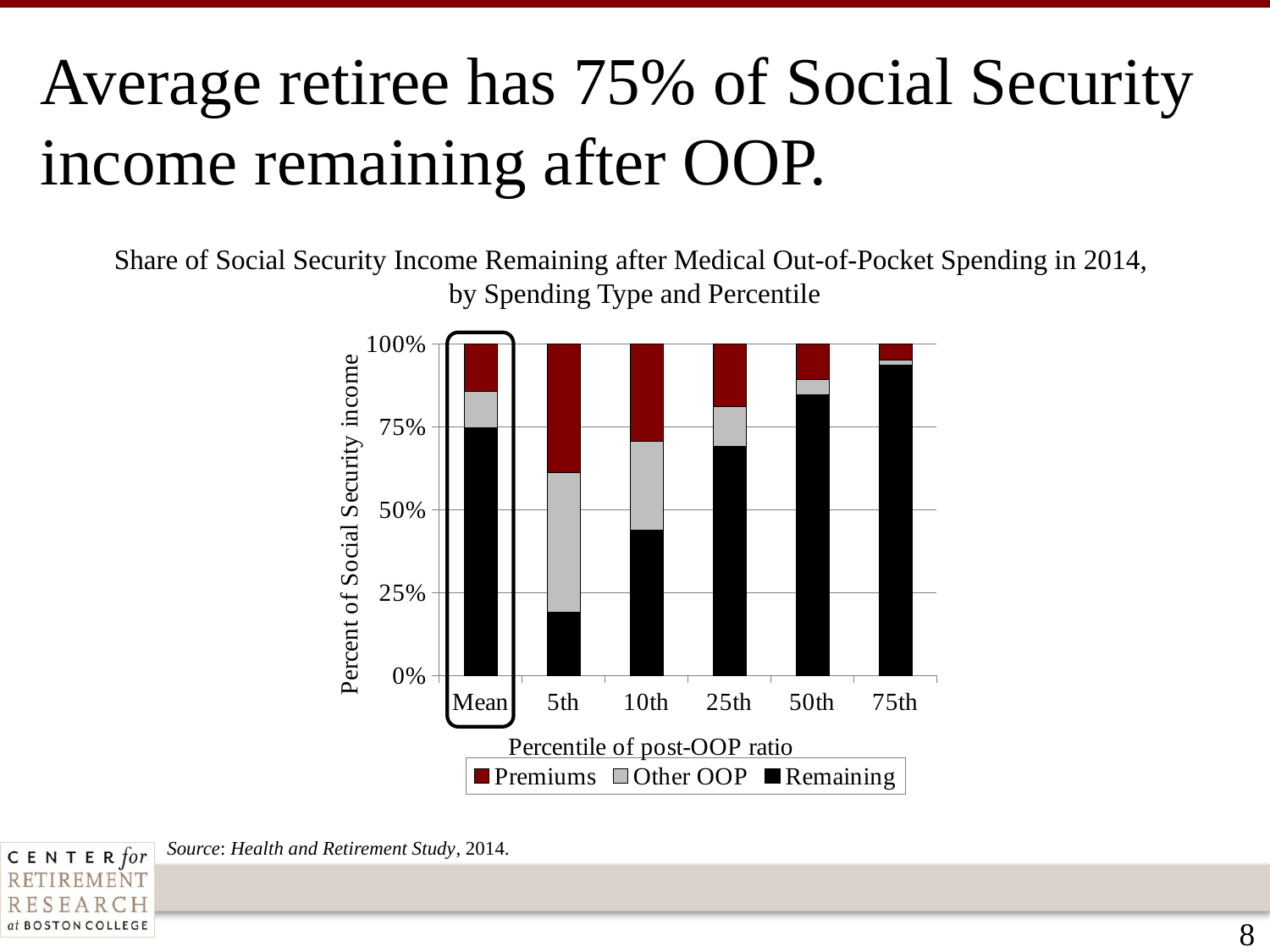
Which has a larger Remaining share, the 10th percentile or the 25th percentile? 25th How many categories are shown on the x axis? 6 Is the Remaining value for the 5th percentile greater or less than 25%? less What kind of chart is shown on the slide? Stacked bar chart Does the Remaining share rise or fall moving from the 5th to the 75th percentile? Rise How many series does the legend list? 3 What is the Remaining value for the Mean bar? 75% Which percentile has the highest Remaining share? 75th Is the Remaining value for the 10th percentile greater or less than 50%? less Is the Remaining value for the 50th percentile greater or less than 75%? greater What is the title of the x axis? Percentile of post-OOP ratio Which percentile has the lowest Remaining share? 5th